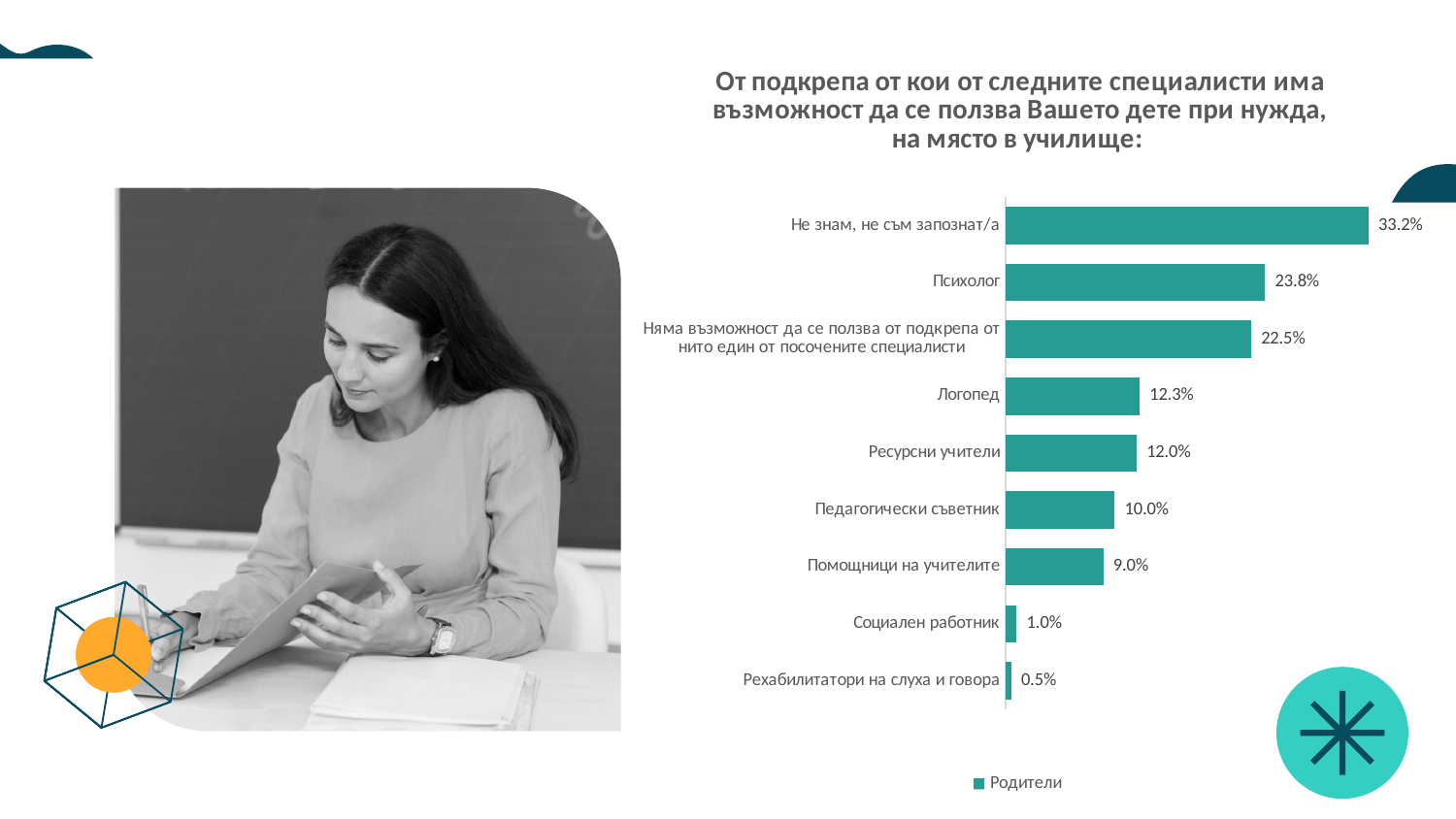
What is the difference between the values for Психолог and Логопед? 11.5% How many series does the legend list? 1 Which category has the highest value? Не знам, не съм запознат/а What is the value for Логопед? 12.3% What is the value for Рехабилитатори на слуха и говора? 0.5% How many categories are shown in the chart? 9 What is the difference between the values for Социален работник and Рехабилитатори на слуха и говора? 0.5% What is the name of the series in the legend? Родители What is the value for Психолог? 23.8% Which category has the lowest value? Рехабилитатори на слуха и говора What kind of chart is shown on the slide? Bar chart Which is larger, the value for Педагогически съветник or the value for Помощници на учителите? Педагогически съветник